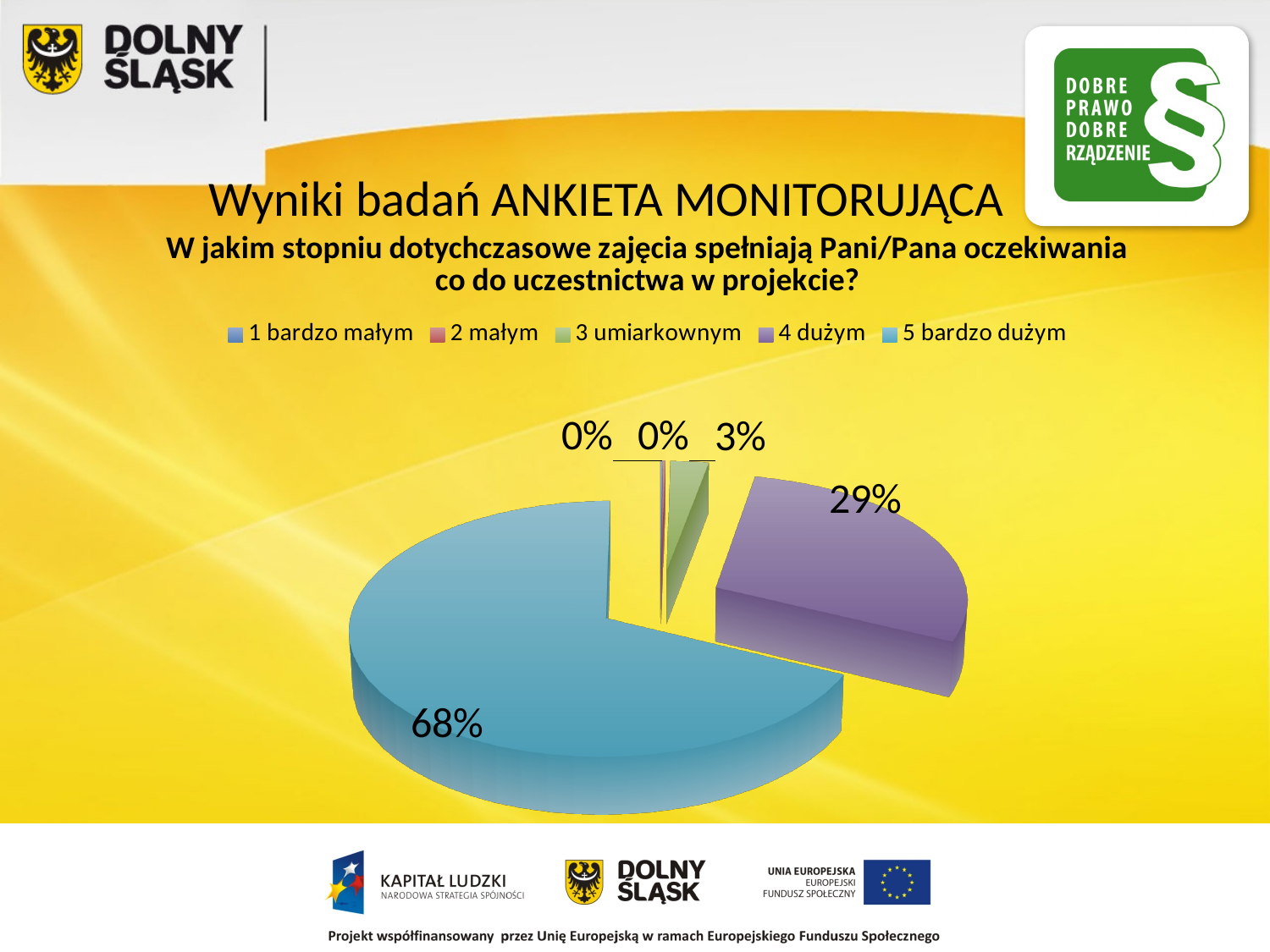
What kind of chart is shown on the slide? pie chart Which category has the largest share of the pie? 5 bardzo dużym What percentage is shown for "4 dużym"? 29% What percentage is shown for "1 bardzo małym"? 0% Which is larger, the share for "4 dużym" or the share for "3 umiarkownym"? 4 dużym What is the difference in percentage points between "5 bardzo dużym" and "4 dużym"? 39 How many categories have a share of 0%? 2 How many categories does the legend list? 5 What percentage is shown for "3 umiarkownym"? 3% What is the combined share of "4 dużym" and "5 bardzo dużym"? 97% What question is the chart answering, according to the subtitle? W jakim stopniu dotychczasowe zajęcia spełniają Pani/Pana oczekiwania co do uczestnictwa w projekcie? What percentage is shown for "5 bardzo dużym"? 68%